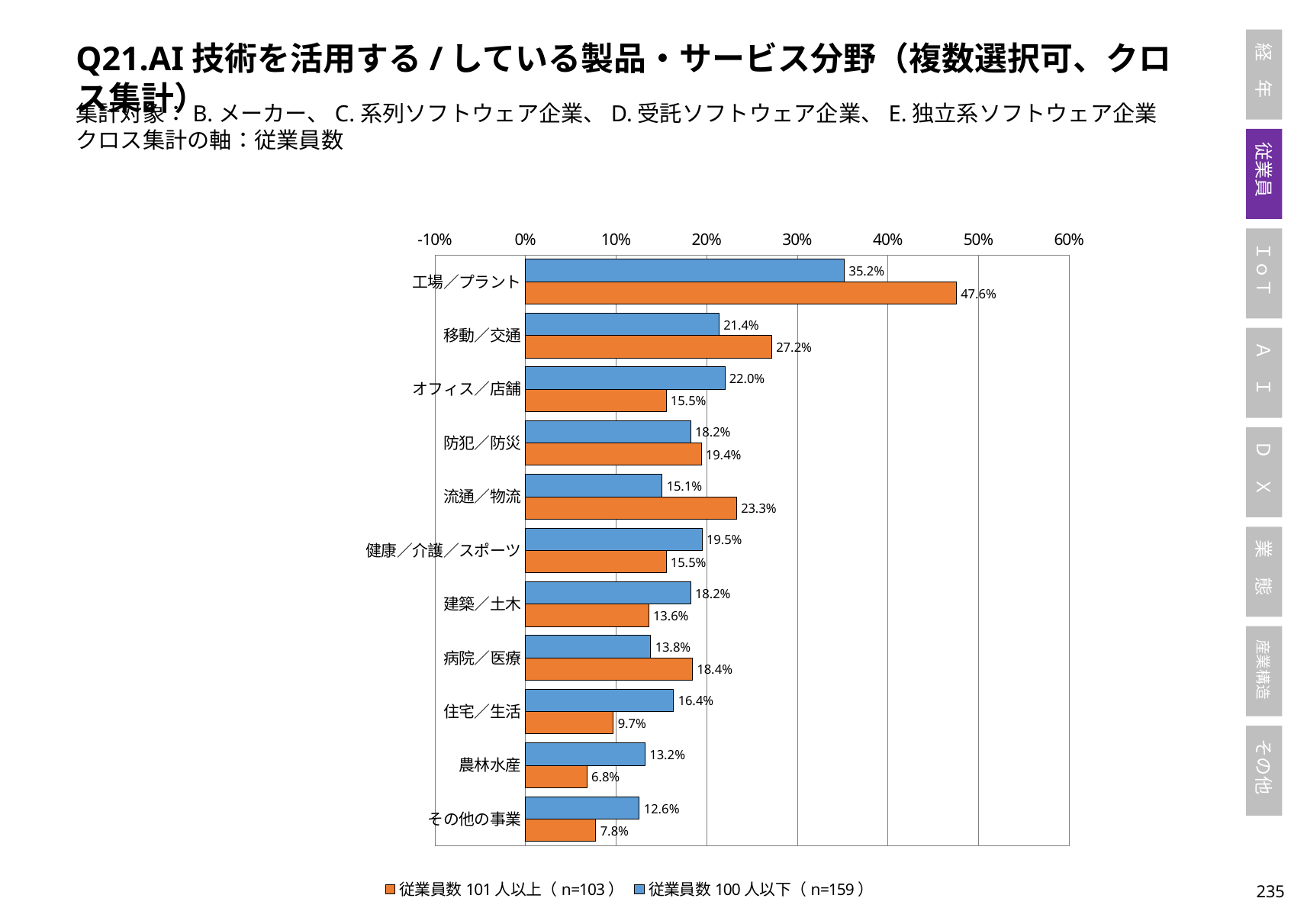
Which category has the highest value in the 従業員数 100 人以下（n=159） series? 工場／プラント What is the value for 農林水産 in the 従業員数 101 人以上（n=103） series? 6.8% How many series does the legend list? 2 Which colour represents the 従業員数 101 人以上（n=103） series? orange Is the value for 移動／交通 in the 従業員数 101 人以上（n=103） series greater or less than 20%? greater What is the value for 流通／物流 in the 従業員数 100 人以下（n=159） series? 15.1% How many categories are plotted on the chart? 11 What type of chart is shown on the slide? bar chart Which category has the lowest value in the 従業員数 101 人以上（n=103） series? 農林水産 For 住宅／生活, which series has the larger value: 従業員数 101 人以上（n=103） or 従業員数 100 人以下（n=159）? 従業員数 100 人以下（n=159） What is the difference between the 従業員数 101 人以上（n=103） and 従業員数 100 人以下（n=159） values for 工場／プラント? 12.4% What is the value for 工場／プラント in the 従業員数 101 人以上（n=103） series? 47.6%